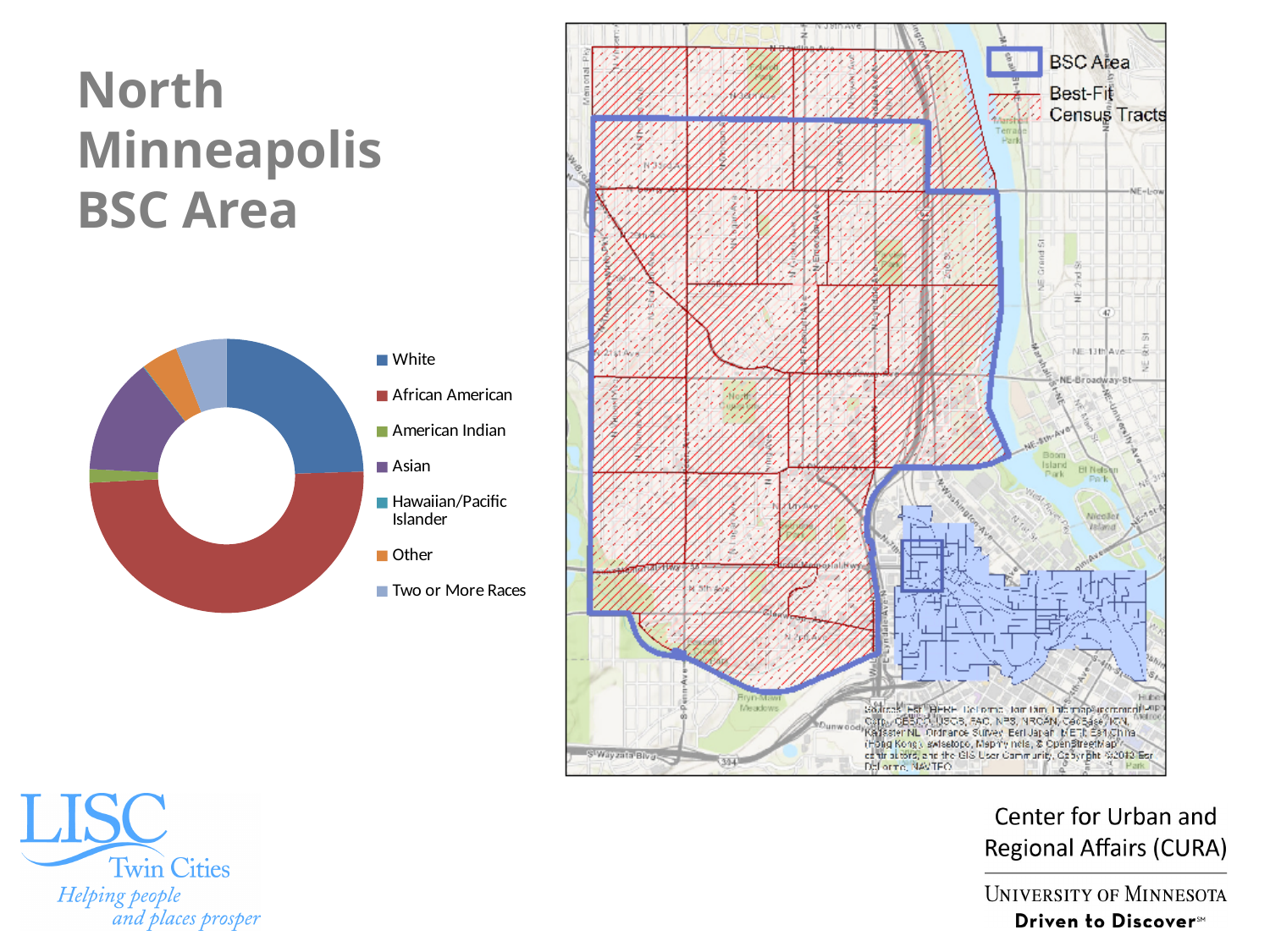
Which category is the second-largest slice in the chart? White What colour is the African American slice in the chart? red Which category has the largest slice in the chart? African American Which slice is larger, African American or White? African American What kind of chart is shown on the slide? doughnut (pie) chart Which slice is larger, Two or More Races or American Indian? Two or More Races Which slice is larger, White or Asian? White How many categories does the chart's legend list? 7 What colour is the White slice in the chart? blue